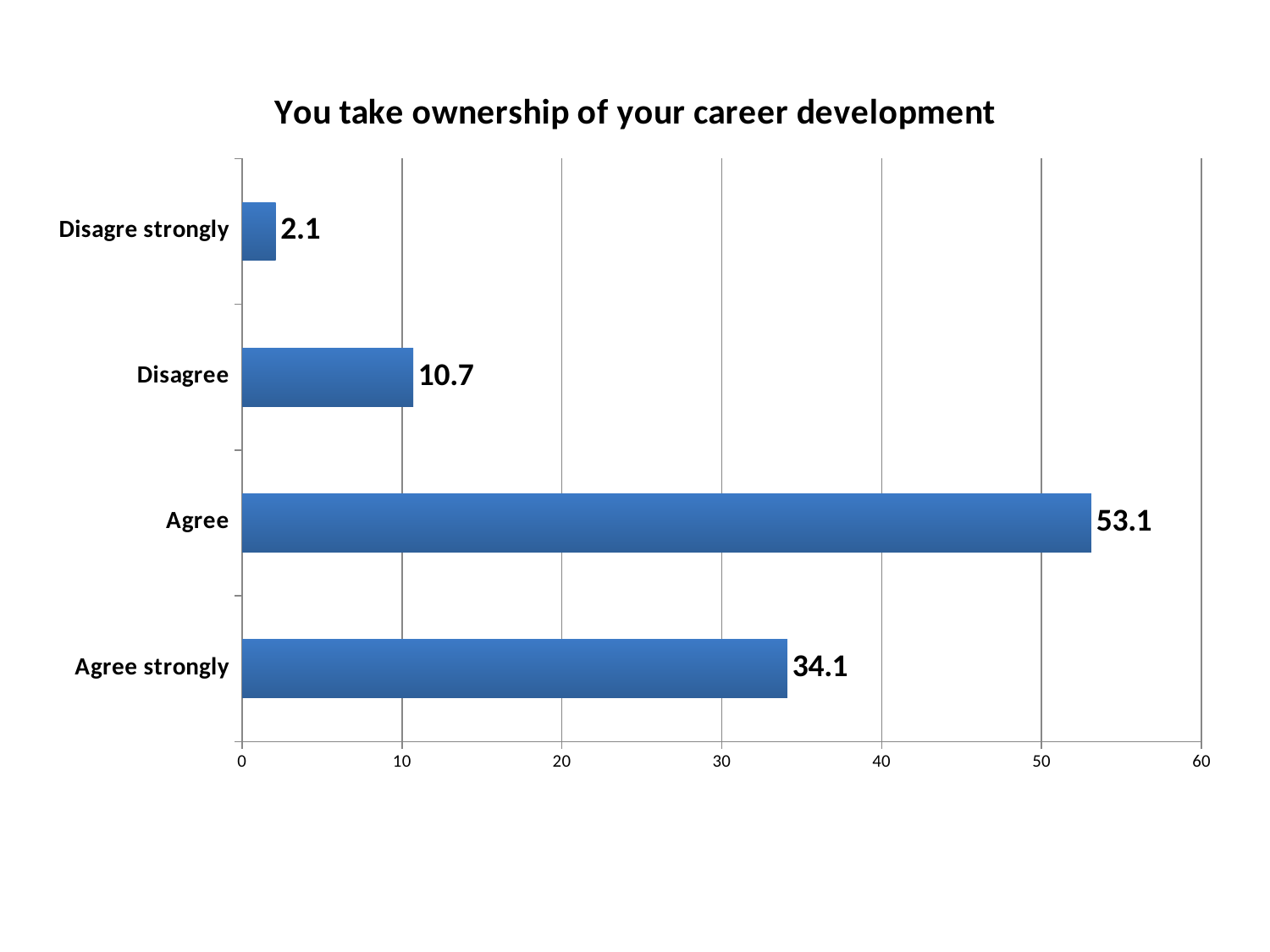
What is the difference between the values for Disagree and Disagre strongly? 8.6 What is the value for Agree strongly? 34.1 What kind of chart is this? Bar chart What is the value for Disagree? 10.7 What is the value for Disagre strongly? 2.1 What is the value for Agree? 53.1 How many categories are shown in the chart? 4 What is the title of the chart? You take ownership of your career development Which category has the lowest value? Disagre strongly Which is larger, the value for Disagree or the value for Agree strongly? Agree strongly Which category has the highest value? Agree What is the difference between the values for Agree and Agree strongly? 19.0